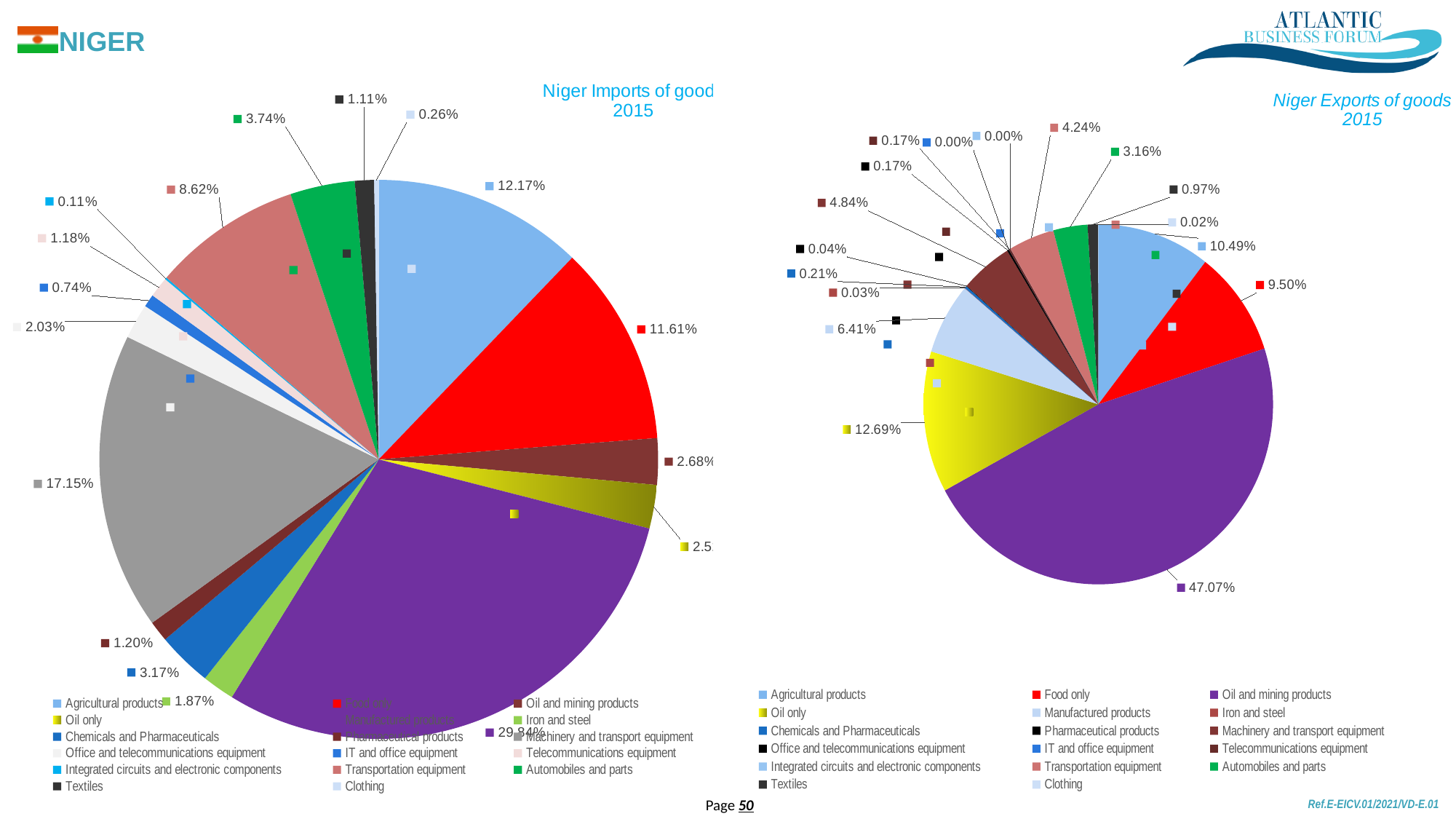
In the Niger Imports of goods 2015 chart, what is the share of Agricultural products? 12.17% In the Niger Exports of goods 2015 chart, what is the share of Food only? 9.50% In the Niger Exports of goods 2015 chart, which category has the largest share? Oil and mining products In the Niger Imports of goods 2015 chart, what is the share of Machinery and transport equipment? 17.15% In the Niger Exports of goods 2015 chart, what is the difference between the shares of Oil and mining products and Oil only? 34.38% What type of chart is used for Niger Imports of goods 2015? Pie chart In the Niger Imports of goods 2015 chart, which category has the largest share? Manufactured products In the Niger Exports of goods 2015 chart, what is the share of Oil only? 12.69% In the Niger Exports of goods 2015 chart, what is the share of Oil and mining products? 47.07% How many categories does the legend of the Niger Exports of goods 2015 chart list? 17 In the Niger Imports of goods 2015 chart, which is larger: the share of Agricultural products or the share of Food only? Agricultural products In the Niger Imports of goods 2015 chart, what is the share of Automobiles and parts? 3.74%